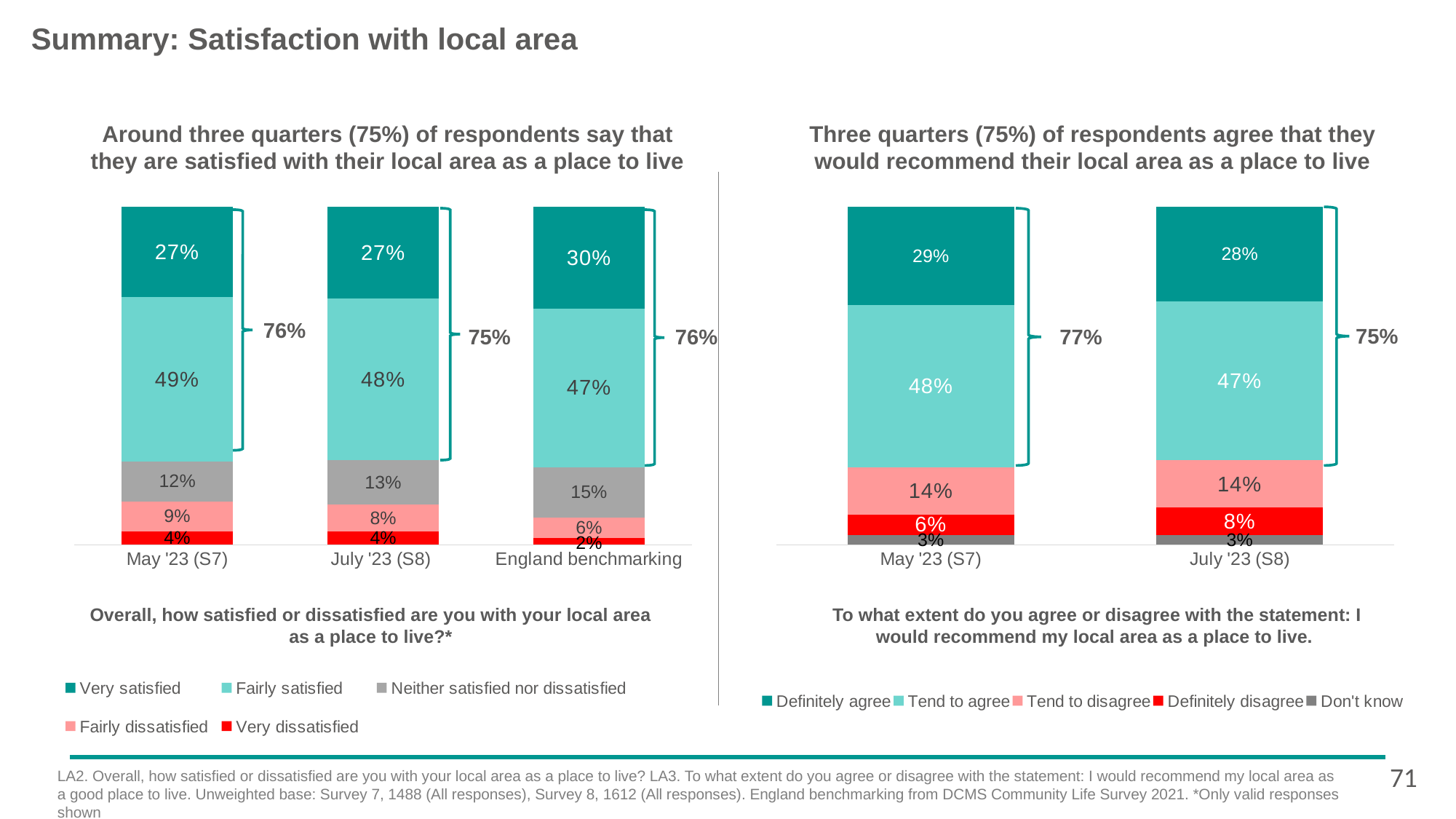
In the left chart (satisfaction with local area), which category has the highest Neither satisfied nor dissatisfied share? England benchmarking In the left chart (satisfaction with local area), how many series does the legend list? 5 In the right chart (recommend local area), which has the larger Definitely agree share, May '23 (S7) or July '23 (S8)? May '23 (S7) In the right chart (recommend local area), what percentage of July '23 (S8) respondents Definitely disagree? 8% In the left chart (satisfaction with local area), what is the difference between the Very dissatisfied share for May '23 (S7) and for England benchmarking? 2 percentage points In the left chart (satisfaction with local area), what percentage of May '23 (S7) respondents are Fairly satisfied? 49% In the left chart (satisfaction with local area), what percentage of England benchmarking respondents are Very satisfied? 30% In the left chart (satisfaction with local area), how many categories are shown on the x axis? 3 What kind of chart is the left chart (satisfaction with local area)? Stacked bar chart In the right chart (recommend local area), what percentage of May '23 (S7) respondents Tend to agree? 48% In the left chart (satisfaction with local area), what combined satisfied percentage is shown by the bracket for July '23 (S8)? 75% In the left chart (satisfaction with local area), what percentage of July '23 (S8) respondents are Neither satisfied nor dissatisfied? 13%